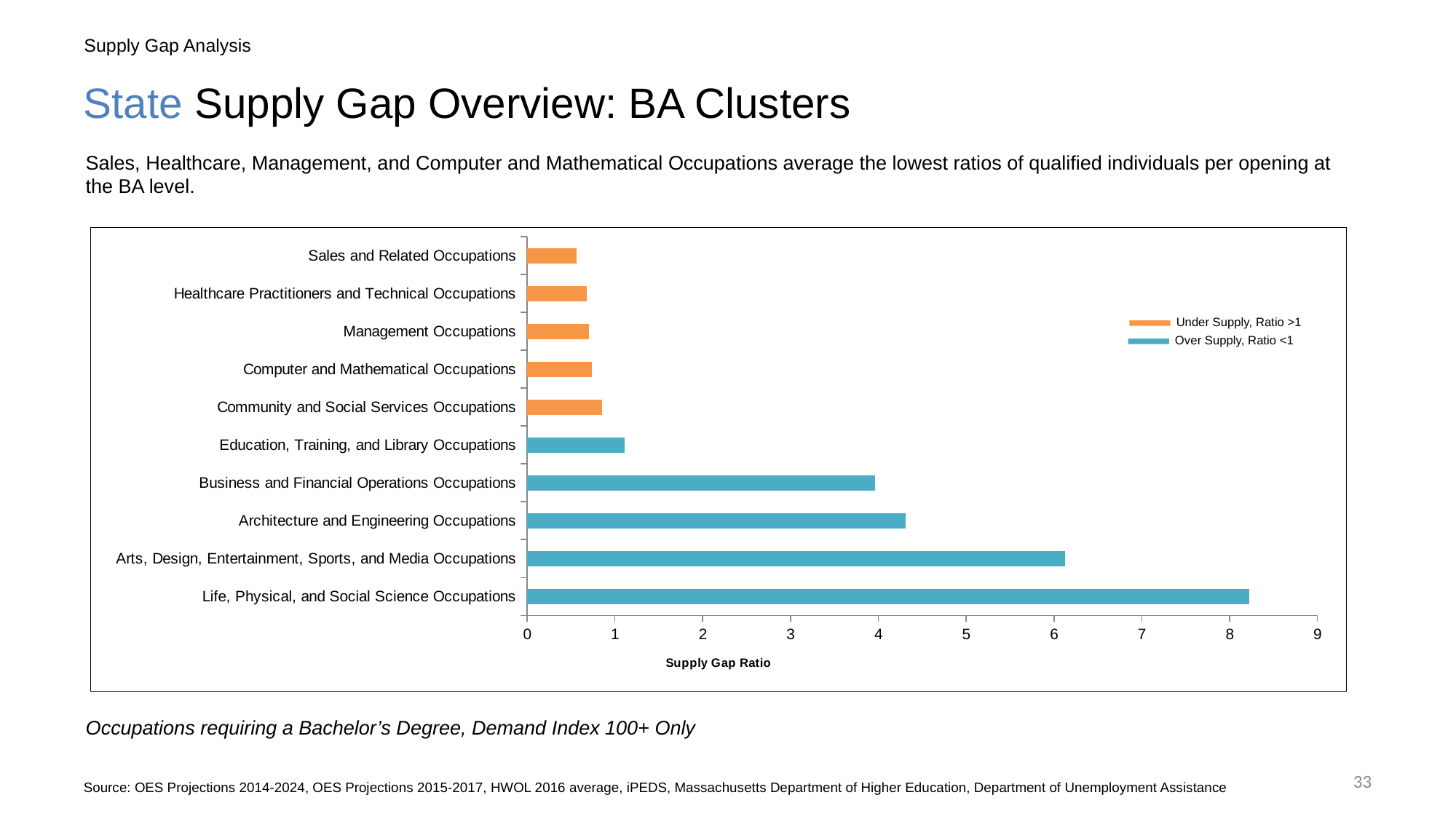
Is the supply gap ratio for Architecture and Engineering Occupations greater or less than 4? greater How many series does the legend list? 2 Is the supply gap ratio for Arts, Design, Entertainment, Sports, and Media Occupations greater or less than 5? greater Which legend entry is shown in orange? Under Supply, Ratio >1 What kind of chart is shown on the slide? bar chart Which occupation category has the highest supply gap ratio? Life, Physical, and Social Science Occupations What is the label of the horizontal axis? Supply Gap Ratio Which has a larger supply gap ratio: Arts, Design, Entertainment, Sports, and Media Occupations or Architecture and Engineering Occupations? Arts, Design, Entertainment, Sports, and Media Occupations Is the supply gap ratio for Sales and Related Occupations greater or less than 1? less Which occupation category has the lowest supply gap ratio? Sales and Related Occupations How many occupation categories are plotted in the chart? 10